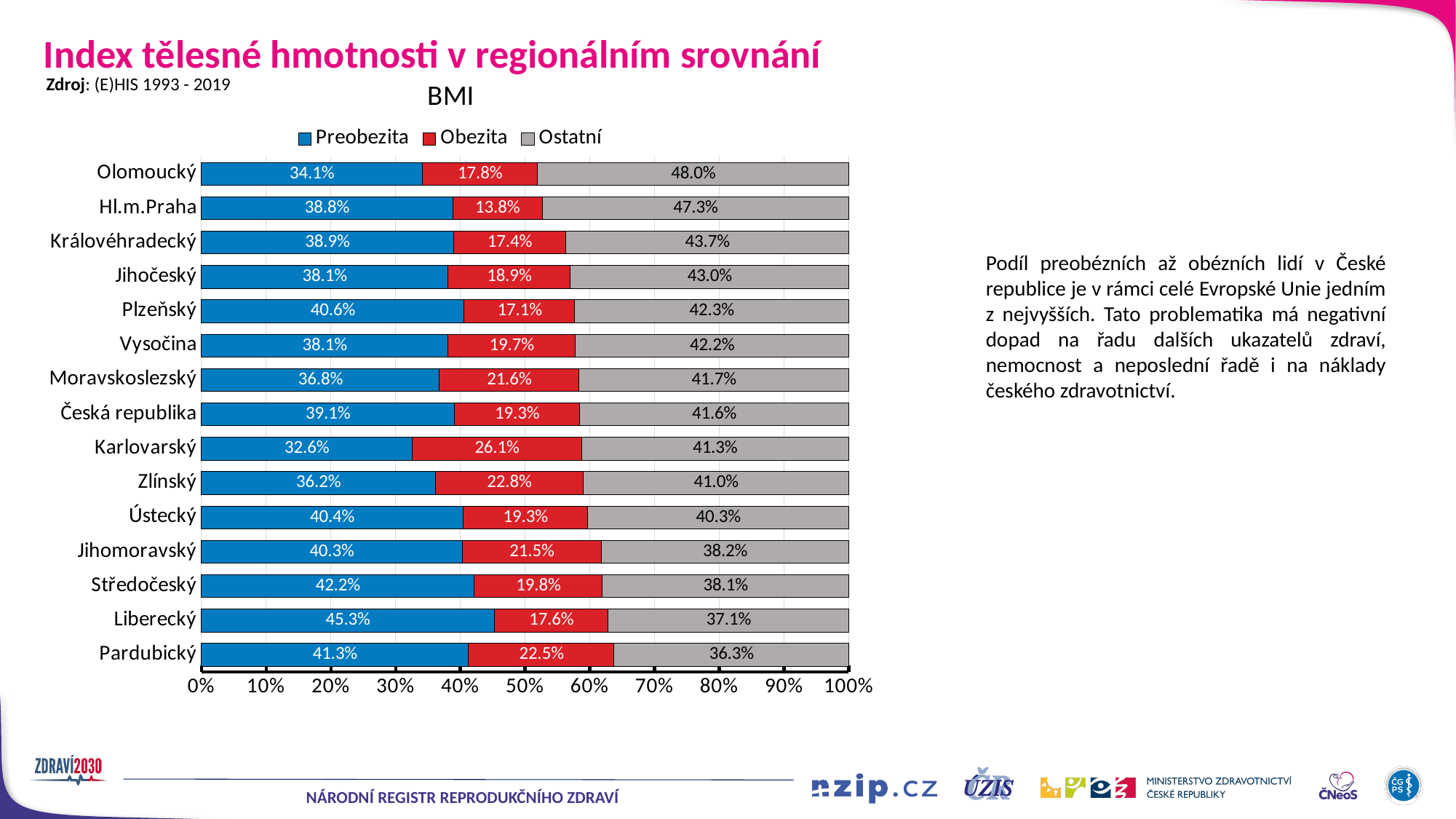
What kind of chart is shown on the slide? Stacked bar chart Which region has the highest Preobezita value? Liberecký What is the difference between the Preobezita values for Liberecký and Karlovarský? 12.7 percentage points Which region has the highest Obezita value? Karlovarský How many series does the legend list? 3 Which region has the lowest Obezita value? Hl.m.Praha Which has the larger Obezita value, Moravskoslezský or Zlínský? Zlínský What is the Obezita value for Karlovarský? 26.1% What are the three legend entries of the chart? Preobezita, Obezita, Ostatní What is the Ostatní value for Česká republika? 41.6% What is the Preobezita value for Liberecký? 45.3% How many regions (categories) are shown in the chart? 15